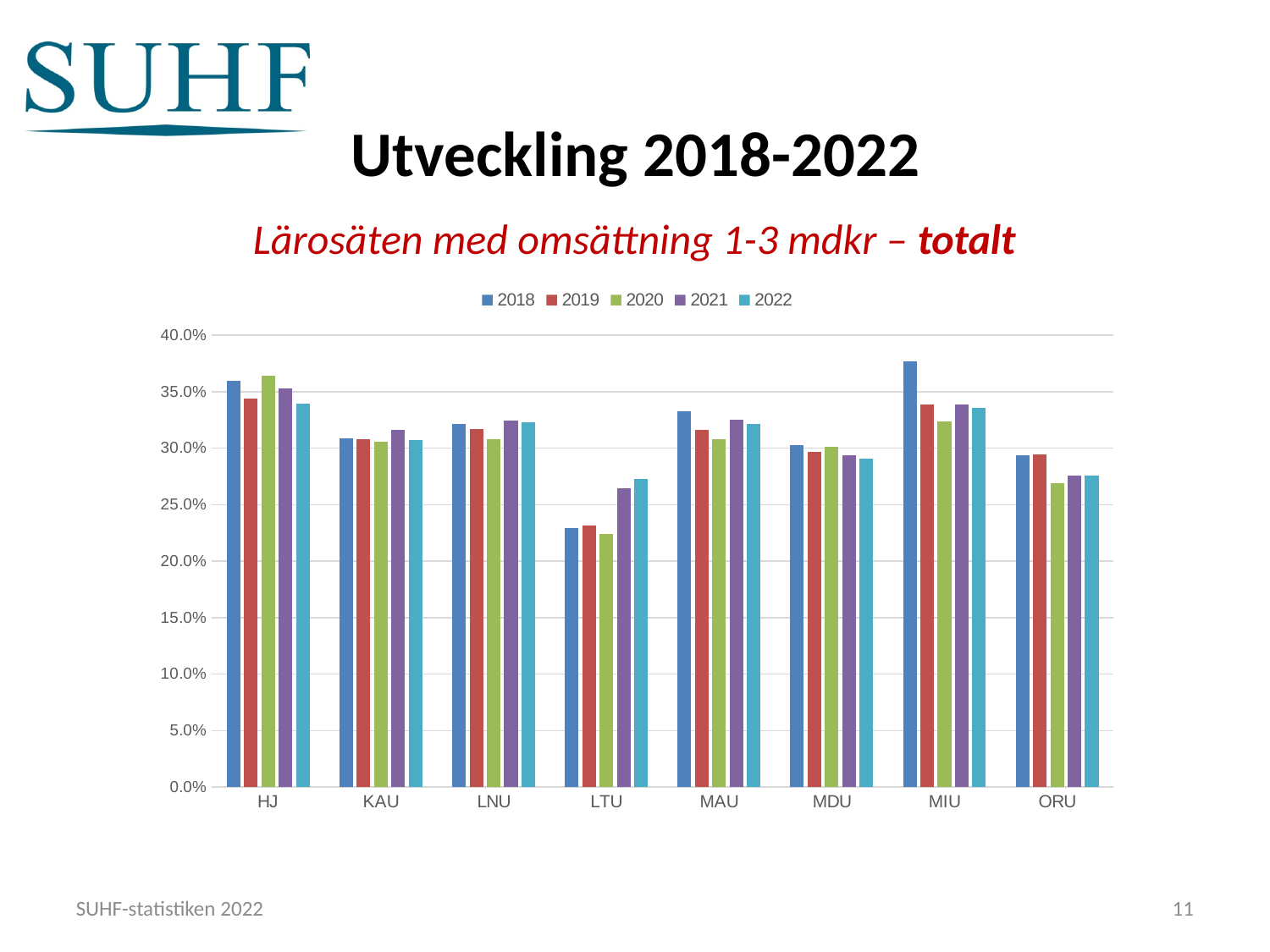
Which institution has the highest value in 2018? MIU Is the value for MIU in 2018 greater or less than 35.0%? greater What years are listed in the chart legend? 2018, 2019, 2020, 2021, 2022 Is the value for ORU in 2020 greater or less than 30.0%? less Is the value for LTU in 2018 greater or less than 25.0%? less What kind of chart is shown on the slide? Bar chart Which is larger for LTU: the 2018 value or the 2022 value? 2022 Which is larger in 2018: the value for MIU or the value for HJ? MIU How many series does the legend list? 5 How many categories (institutions) are shown on the x axis? 8 Does the value for ORU rise or fall from 2018 to 2022? fall Which institution has the lowest value in 2020? LTU